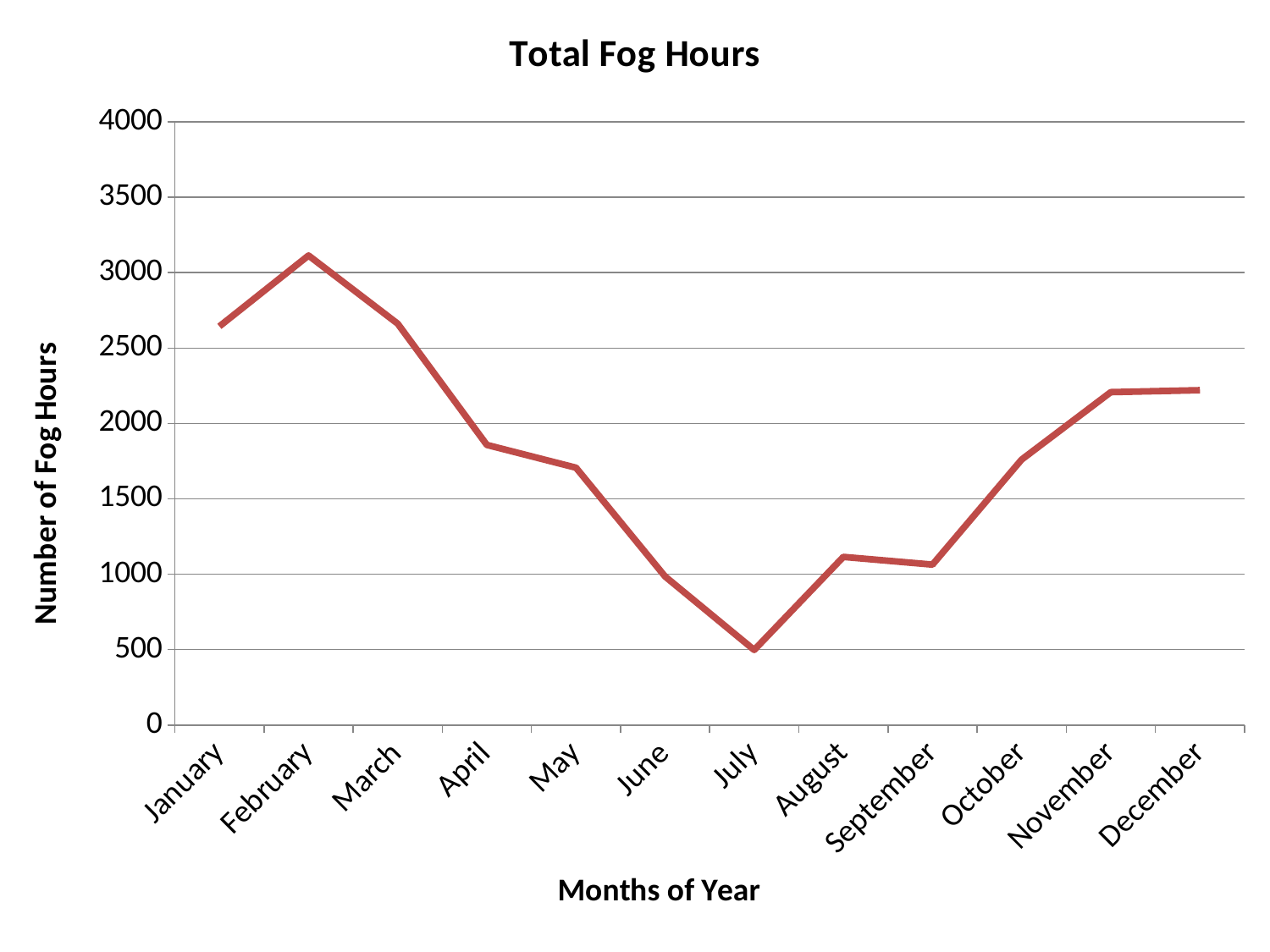
Is the value for April greater or less than 2000? less What kind of chart is shown on the slide? line chart What is the label on the vertical axis? Number of Fog Hours What is the title of the chart? Total Fog Hours Which month has the lowest number of fog hours? July Is the value for July greater or less than 1000? less Is the value for December greater or less than 2000? greater How many months are plotted on the x axis? 12 Which month has more fog hours, February or December? February Which month has the highest number of fog hours? February Do the fog hours rise or fall from February to July? fall